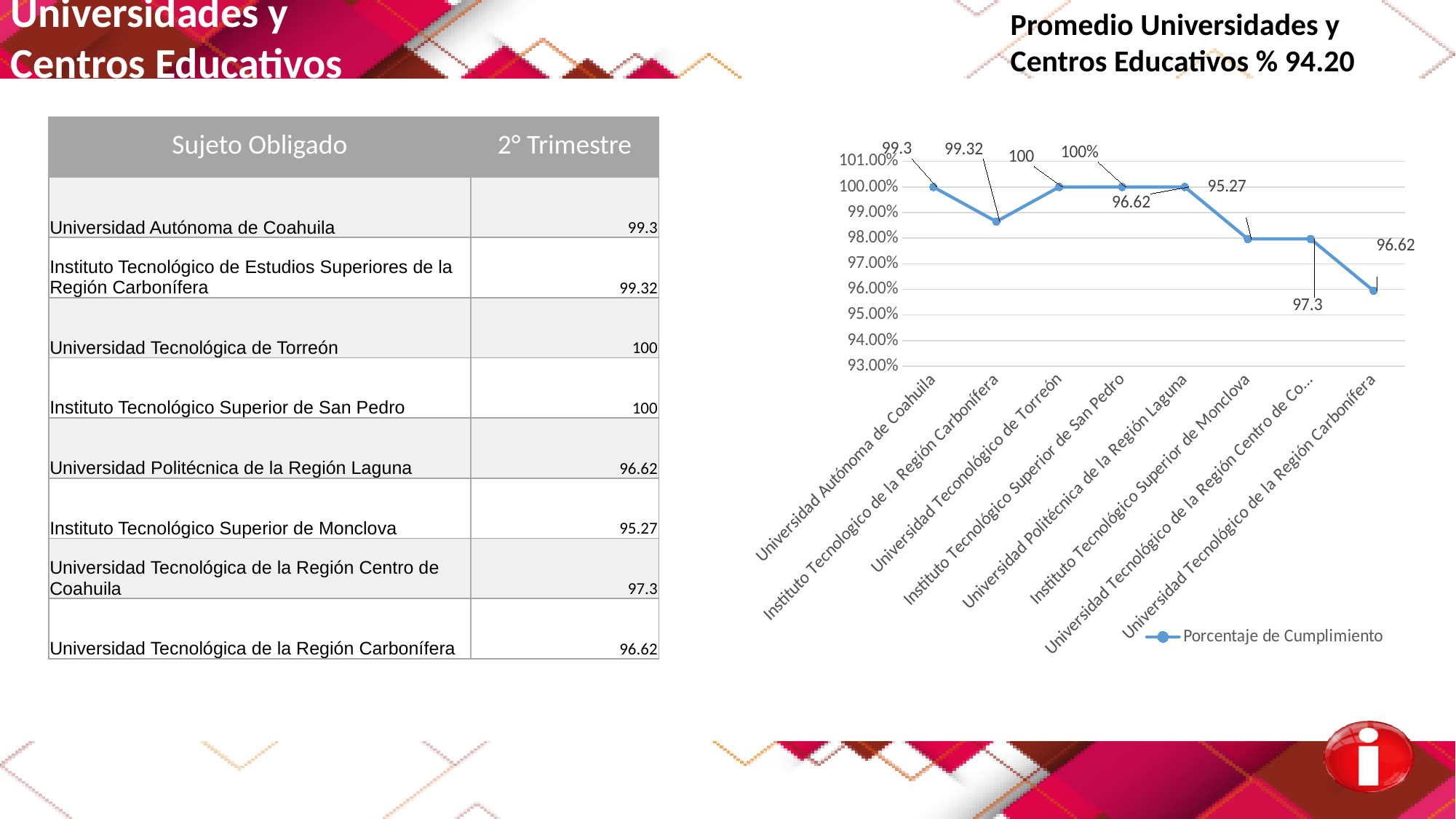
What is the data label for Instituto Tecnológico Superior de Monclova in the chart? 95.27 What is the name of the series shown in the chart legend? Porcentaje de Cumplimiento How many categories are plotted on the x axis of the chart? 8 What is the data label for Universidad Tecnológica de la Región Carbonífera in the chart? 96.62 What kind of chart is shown on the slide? line chart According to the data labels, which is larger: Universidad Politécnica de la Región Laguna or Instituto Tecnológico Superior de Monclova? Universidad Politécnica de la Región Laguna According to the data labels, what is the difference between Universidad Tecnológica de la Región Centro de Coahuila (97.3) and Universidad Tecnológica de la Región Carbonífera (96.62)? 0.68 What is the lowest value shown on the chart's y axis? 93.00% What is the data label for Instituto Tecnológico de la Región Carbonífera in the chart? 99.32 What is the data label for Universidad Autónoma de Coahuila in the chart? 99.3 What is the data label for Universidad Politécnica de la Región Laguna in the chart? 96.62 How many series does the chart legend list? 1